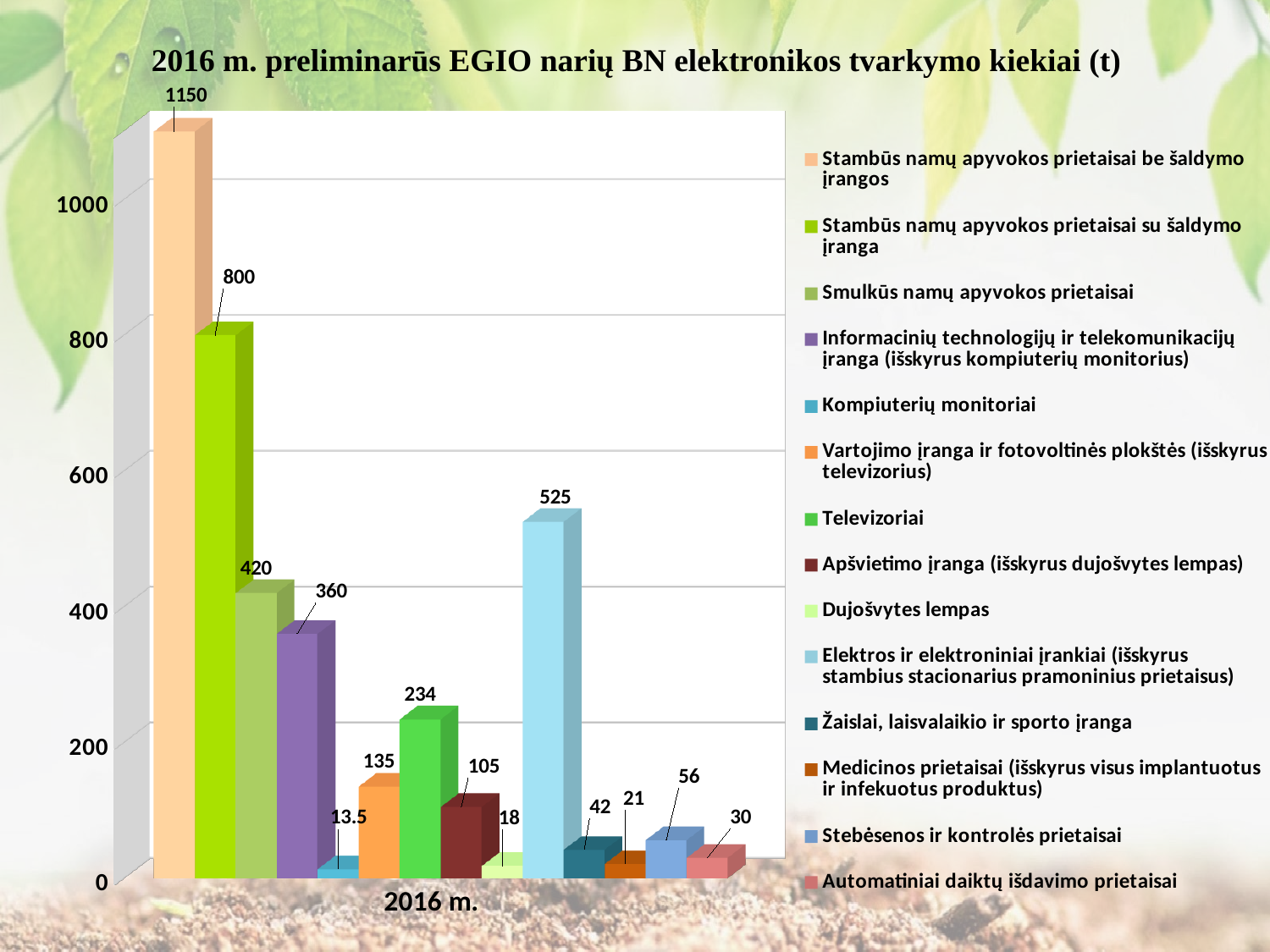
What is the difference between the values for Stambūs namų apyvokos prietaisai be šaldymo įrangos and Stambūs namų apyvokos prietaisai su šaldymo įranga? 350 Which series has the lowest value? Kompiuterių monitoriai What is the title of the chart? 2016 m. preliminarūs EGIO narių BN elektronikos tvarkymo kiekiai (t) What kind of chart is shown on the slide? bar chart How many series does the legend list? 14 Which is larger, the value for Smulkūs namų apyvokos prietaisai or the value for Informacinių technologijų ir telekomunikacijų įranga (išskyrus kompiuterių monitorius)? Smulkūs namų apyvokos prietaisai Which series has the highest value? Stambūs namų apyvokos prietaisai be šaldymo įrangos What is the value for Stebėsenos ir kontrolės prietaisai? 56 Is the value for Televizoriai greater or less than 200? greater What is the value for Kompiuterių monitoriai? 13.5 What is the value for Elektros ir elektroniniai įrankiai (išskyrus stambius stacionarius pramoninius prietaisus)? 525 What is the value for Televizoriai? 234